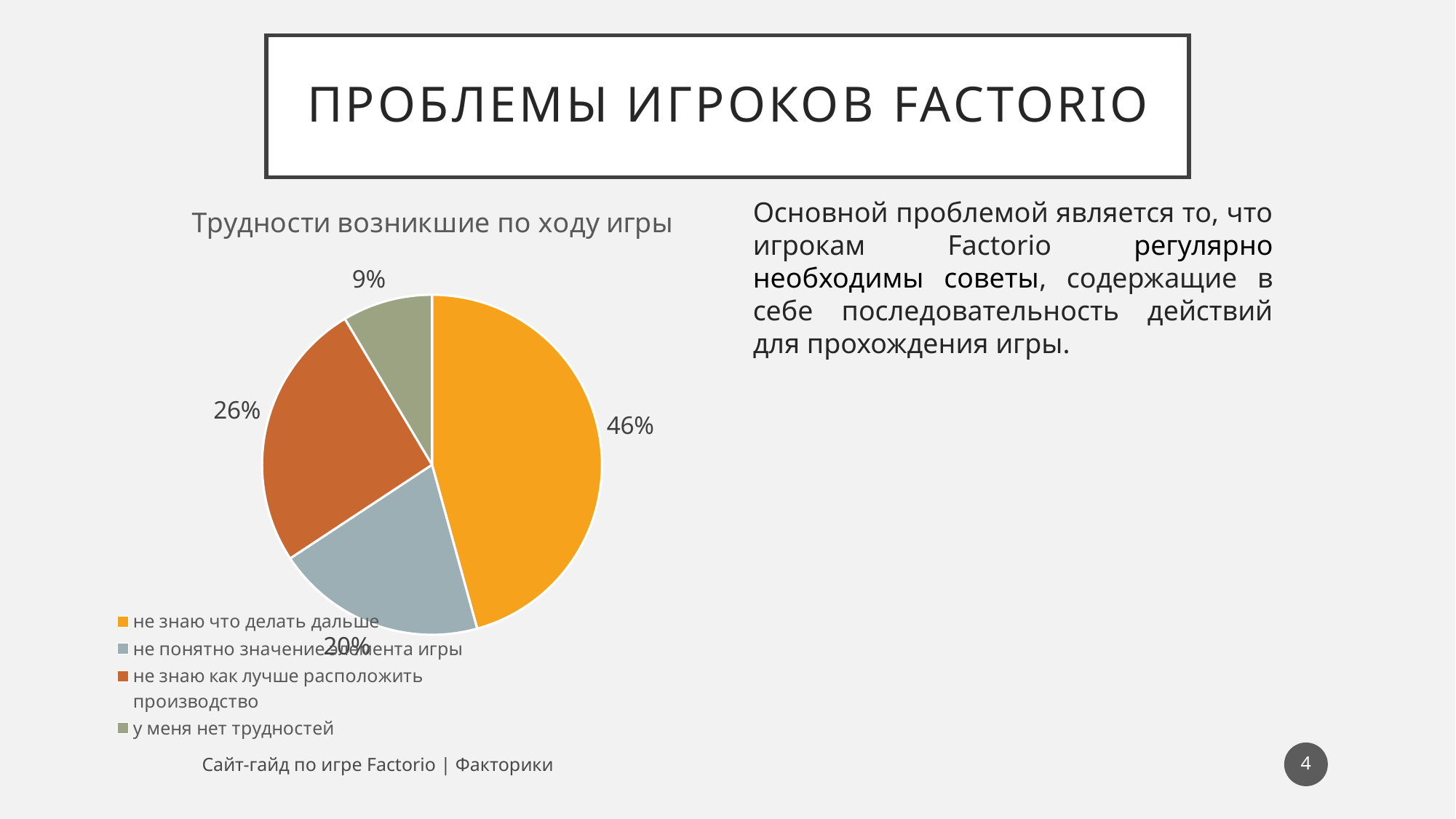
Which is larger: the slice for "не знаю как лучше расположить производство" or the slice for "не понятно значение элемента игры"? не знаю как лучше расположить производство How many categories does the pie chart show? 4 What share of the pie does "у меня нет трудностей" take? 9% What share of the pie does "не знаю что делать дальше" take? 46% What is the difference in percentage points between "не знаю что делать дальше" and "не знаю как лучше расположить производство"? 20 Which category has the smallest slice of the pie? у меня нет трудностей What is the title of the chart? Трудности возникшие по ходу игры What share of the pie does "не знаю как лучше расположить производство" take? 26% Which category has the largest slice of the pie? не знаю что делать дальше What colour is the slice for "у меня нет трудностей"? Olive green What kind of chart is shown on the slide? Pie chart